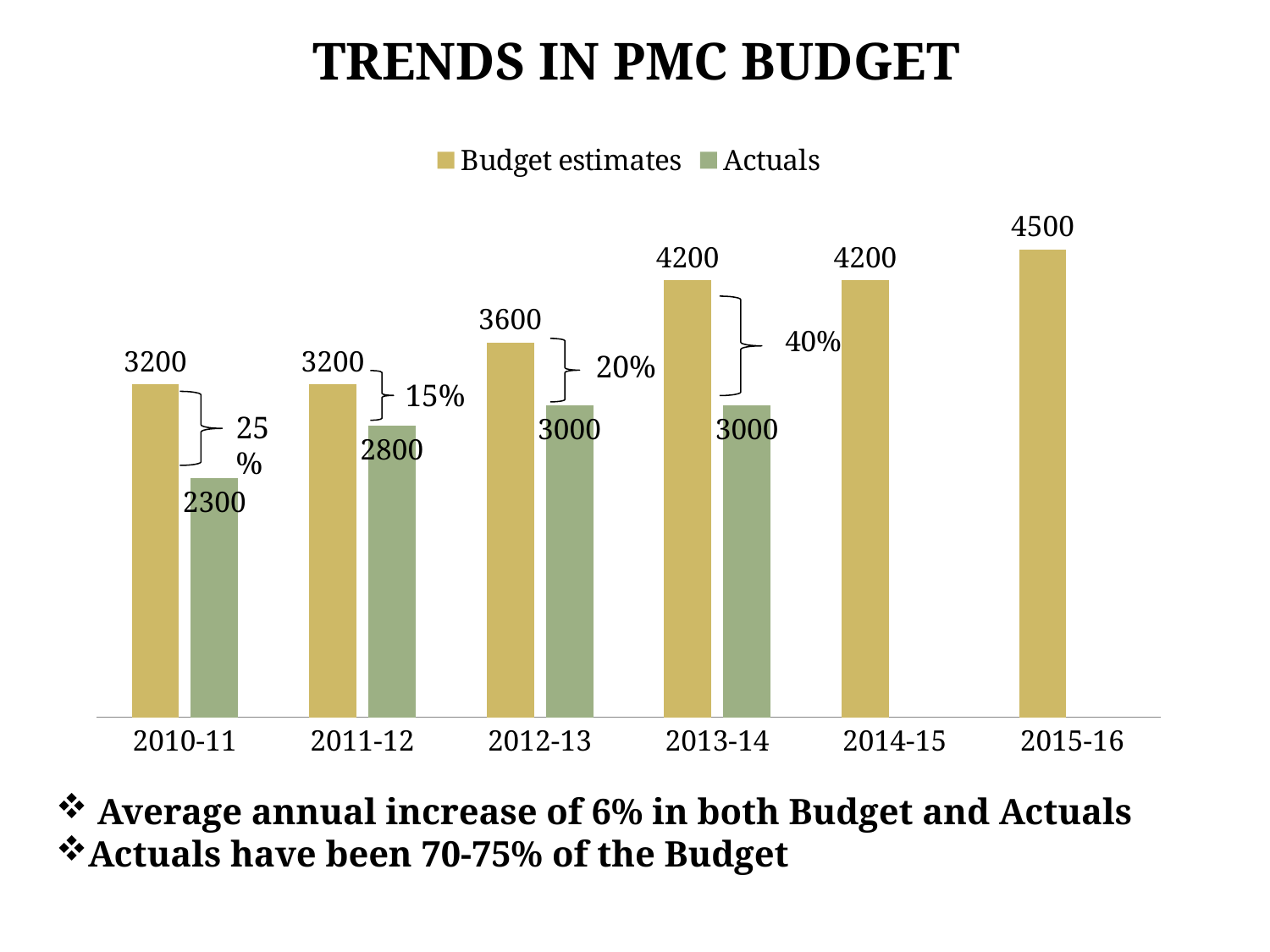
Which is larger, the Budget estimates value for 2011-12 or the Actuals value for 2012-13? Budget estimates for 2011-12 What is the title of the chart? TRENDS IN PMC BUDGET What is the difference between the Budget estimates and Actuals values for 2013-14? 1200 What is the Budget estimates value for 2015-16? 4500 Which year has the highest Budget estimates value? 2015-16 What kind of chart is shown on the slide? Bar chart What is the Budget estimates value for 2012-13? 3600 How many years are shown on the x axis? 6 What is the Actuals value for 2011-12? 2800 Which year has the lowest Actuals value? 2010-11 What is the Actuals value for 2010-11? 2300 How many series does the legend list? 2